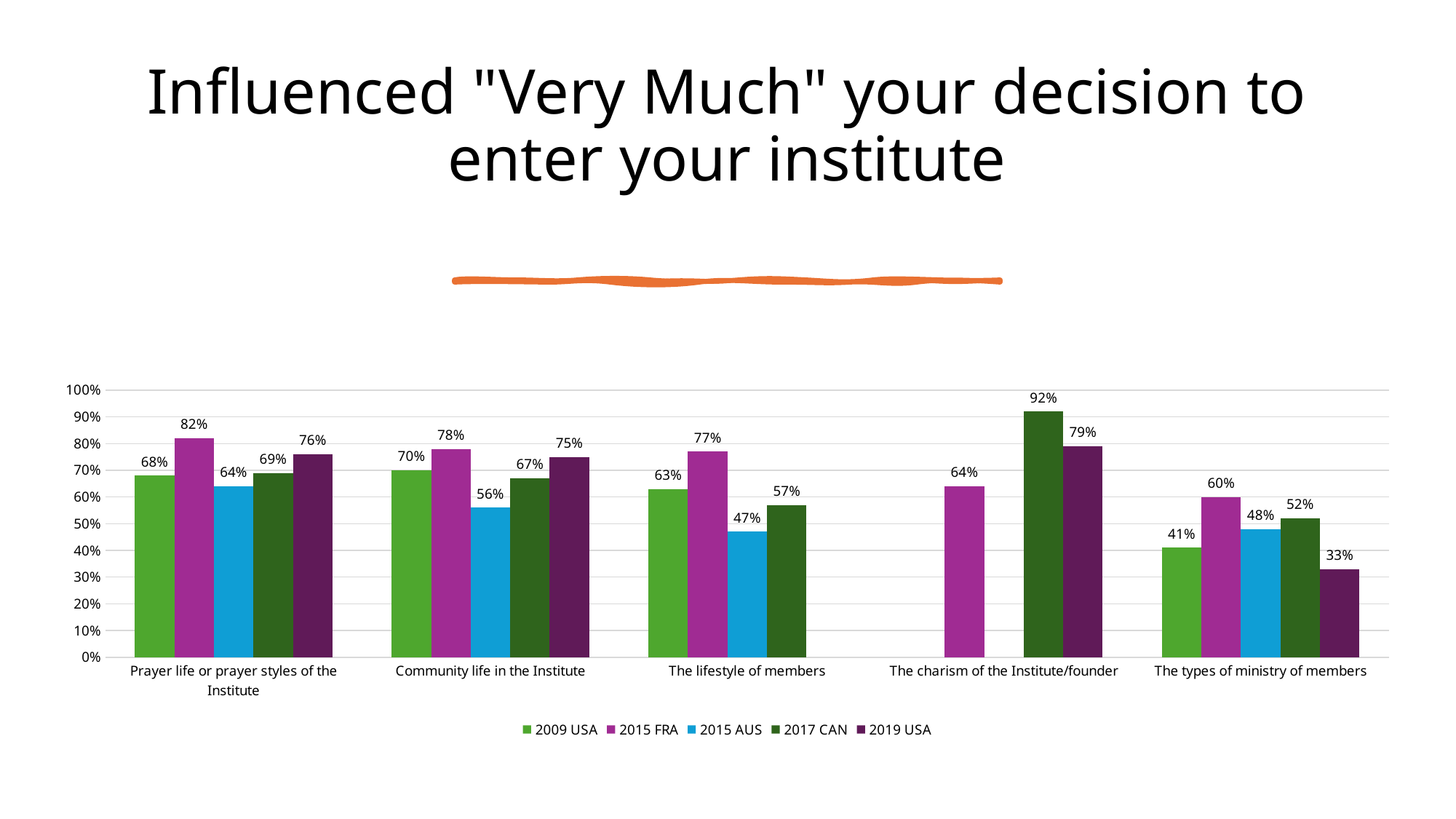
Which series has the highest value for "Community life in the Institute"? 2015 FRA What kind of chart is shown on the slide? Bar chart Which is larger for "Prayer life or prayer styles of the Institute": the 2009 USA value or the 2019 USA value? 2019 USA What is the title of the slide? Influenced "Very Much" your decision to enter your institute What is the value for 2017 CAN for "The charism of the Institute/founder"? 92% What is the value for 2019 USA for "The types of ministry of members"? 33% Which series has the lowest value for "The types of ministry of members"? 2019 USA What is the value for 2015 FRA for "Prayer life or prayer styles of the Institute"? 82% How many series does the legend list? 5 What is the value for 2015 AUS for "The lifestyle of members"? 47% How many categories are shown on the x axis? 5 What is the difference between the 2017 CAN and 2019 USA values for "The charism of the Institute/founder"? 13%